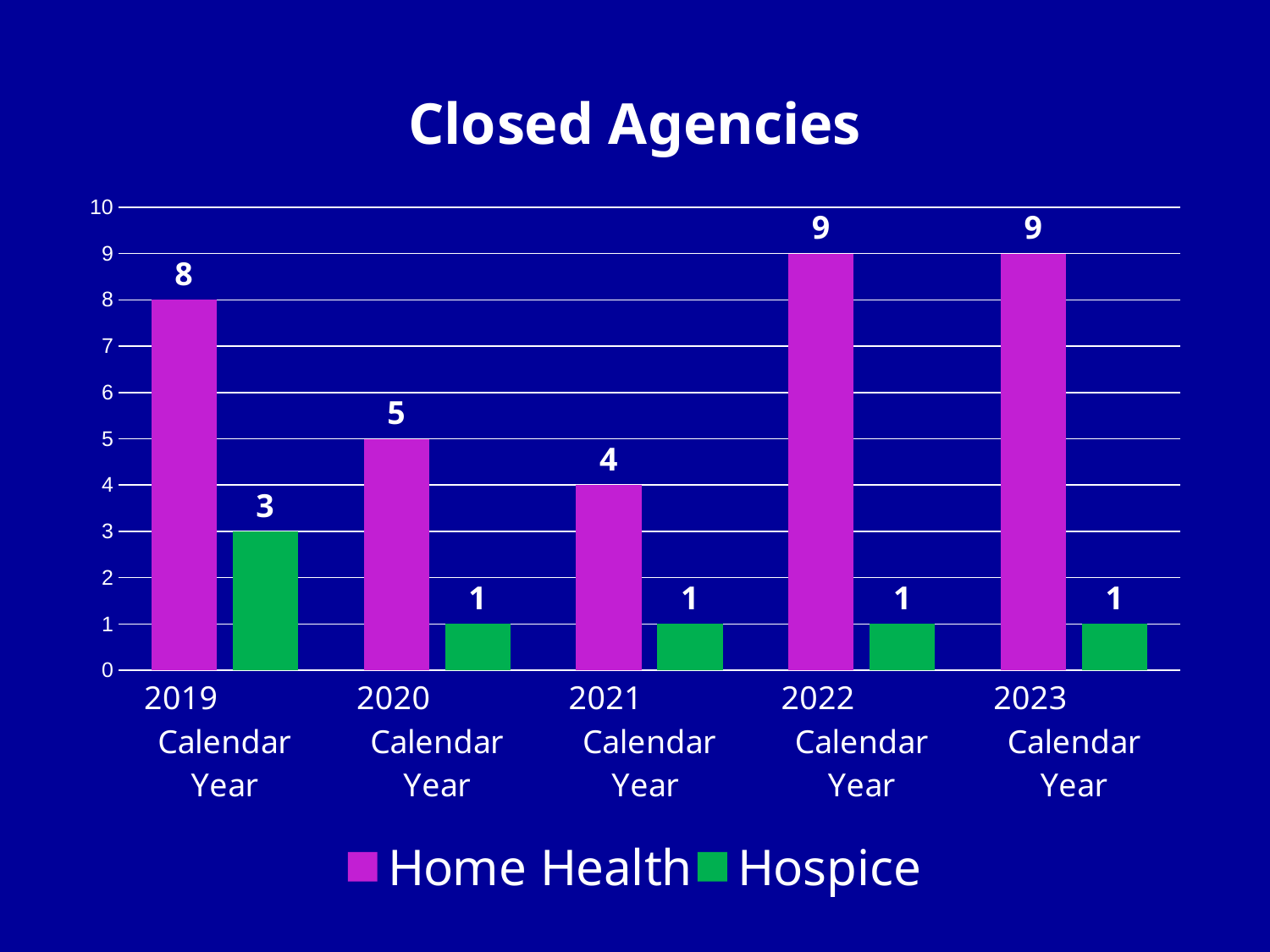
What is the Home Health value for 2021 Calendar Year? 4 What is the Hospice value for 2019 Calendar Year? 3 How many calendar years are shown on the x axis? 5 What is the difference between the Home Health and Hospice values for 2020 Calendar Year? 4 What is the title of the chart? Closed Agencies Which calendar year has the highest Hospice value? 2019 Calendar Year Which is larger, the Home Health value for 2019 or the Home Health value for 2020? 2019 Which calendar year has the lowest Home Health value? 2021 Calendar Year How many series does the legend list? 2 What is the Home Health value for 2019 Calendar Year? 8 What colour represents the Hospice series? green What kind of chart is shown? bar chart